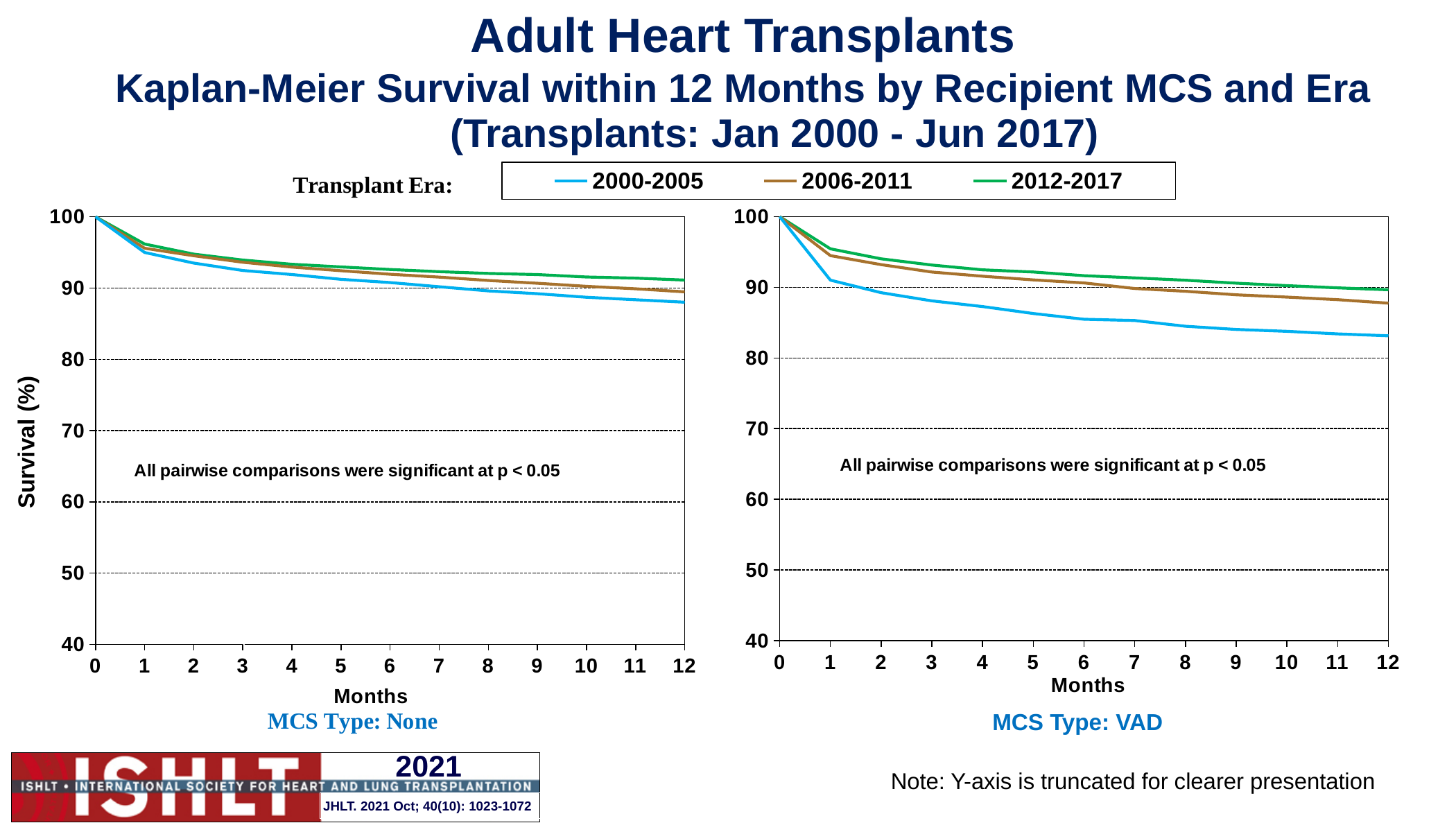
In the 'MCS Type: VAD' chart, is the survival for the 2000-2005 era at 12 months greater or less than 90? less How many transplant eras does the legend list? 3 In the 'MCS Type: None' chart, is the survival for the 2000-2005 era at 12 months greater or less than 90? less In the 'MCS Type: VAD' chart, is the survival for the 2000-2005 era at 6 months greater or less than 90? less In the 'MCS Type: VAD' chart, which transplant era has the lowest survival at 12 months? 2000-2005 In the 'MCS Type: VAD' chart, which transplant era has the highest survival at 12 months? 2012-2017 In the 'MCS Type: None' chart, which transplant era has the lowest survival at 12 months? 2000-2005 What kind of chart is the 'MCS Type: None' chart on the left? line chart What is the label of the y-axis shared by both charts? Survival (%) In the 'MCS Type: VAD' chart, which era has higher survival at 12 months, 2012-2017 or 2000-2005? 2012-2017 Which colour represents the 2012-2017 transplant era in the legend? green In the 'MCS Type: None' chart, does survival for the 2006-2011 era rise or fall as months increase? fall